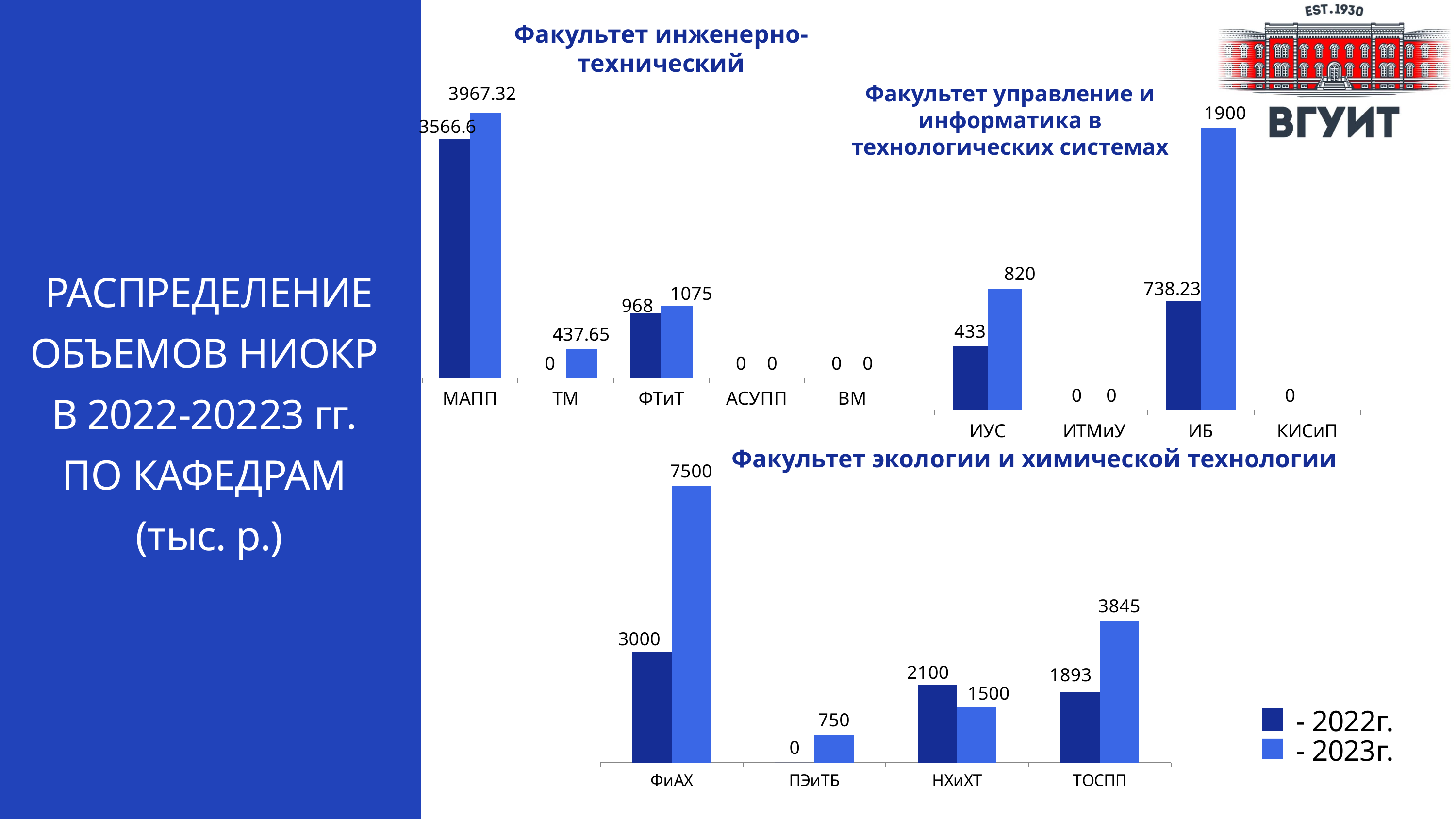
In the chart titled "Факультет управление и информатика в технологических системах", what is the value for ИУС in 2022г.? 433 In the chart titled "Факультет инженерно-технический", how many categories are shown on the x axis? 5 How many series does the legend on the slide list? 2 In the chart titled "Факультет инженерно-технический", what is the difference between the 2023г. and 2022г. values for ФТиТ? 107 In the chart titled "Факультет инженерно-технический", what is the value for МАПП in 2023г.? 3967.32 In the chart titled "Факультет управление и информатика в технологических системах", which is larger: the 2022г. value for ИУС or the 2022г. value for ИБ? ИБ In the chart titled "Факультет экологии и химической технологии", what is the difference between the 2022г. and 2023г. values for НХиХТ? 600 In the chart titled "Факультет управление и информатика в технологических системах", what is the value for ИБ in 2023г.? 1900 In the chart titled "Факультет экологии и химической технологии", what is the value for ФиАХ in 2023г.? 7500 In the chart titled "Факультет инженерно-технический", what is the value for ТМ in 2023г.? 437.65 In the chart titled "Факультет экологии и химической технологии", which category has the lowest value in 2022г.? ПЭиТБ In the chart titled "Факультет инженерно-технический", which category has the highest value in 2022г.? МАПП